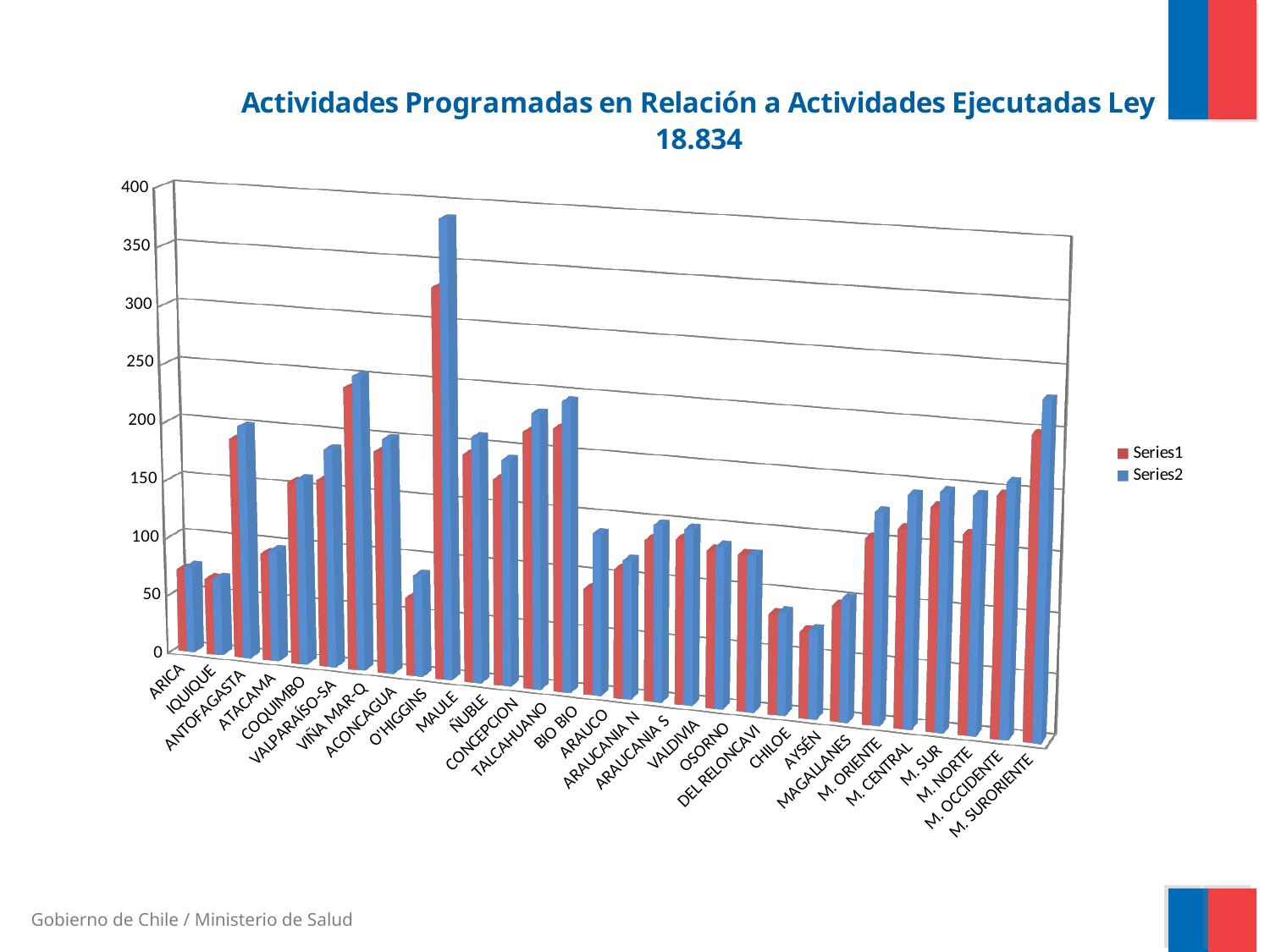
How many categories are shown along the x axis? 29 Which is larger, the Series2 value for MAULE or the Series2 value for VIÑA MAR-Q? MAULE Which is larger, the Series1 value for ANTOFAGASTA or the Series1 value for IQUIQUE? ANTOFAGASTA Is the Series1 value for ARICA greater or less than 100? less Is the Series1 value for MAULE greater or less than 300? greater What is the title of the chart? Actividades Programadas en Relación a Actividades Ejecutadas Ley 18.834 Is the Series2 value for AYSÉN greater or less than 50? greater Which category has the highest value for Series2? MAULE What kind of chart is shown on the slide? bar chart How many series does the legend list? 2